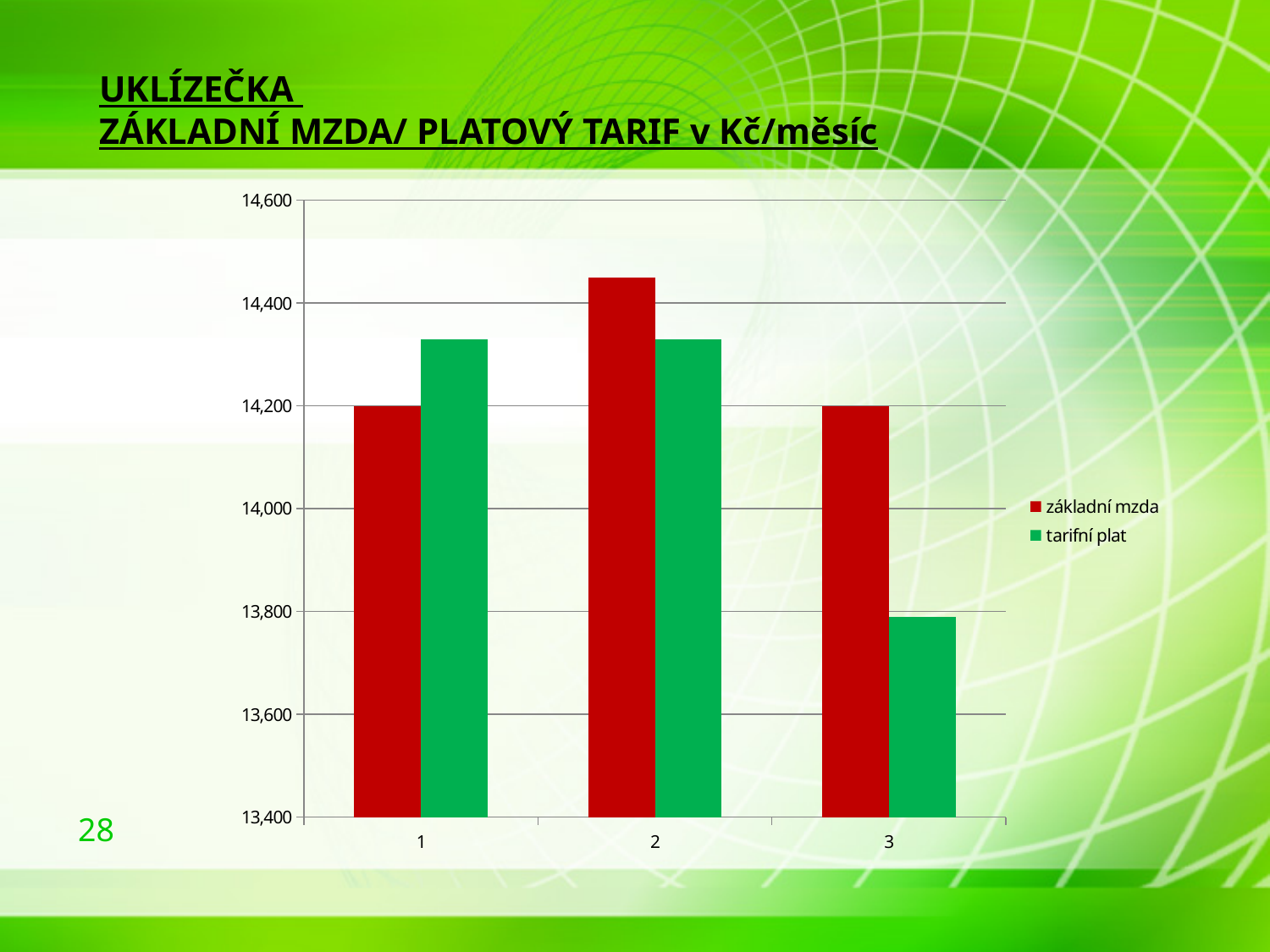
What are the two series named in the legend? základní mzda and tarifní plat Which category has the highest value for základní mzda? 2 What colour are the bars for základní mzda? red Is the value for základní mzda in category 2 greater or less than 14,400? greater What kind of chart is shown on the slide? bar chart Which category has the lowest value for tarifní plat? 3 Is the value for tarifní plat in category 1 greater or less than 14,200? greater How many categories are shown on the x axis? 3 In category 3, which is larger: základní mzda or tarifní plat? základní mzda How many series does the legend list? 2 In category 1, which is larger: základní mzda or tarifní plat? tarifní plat